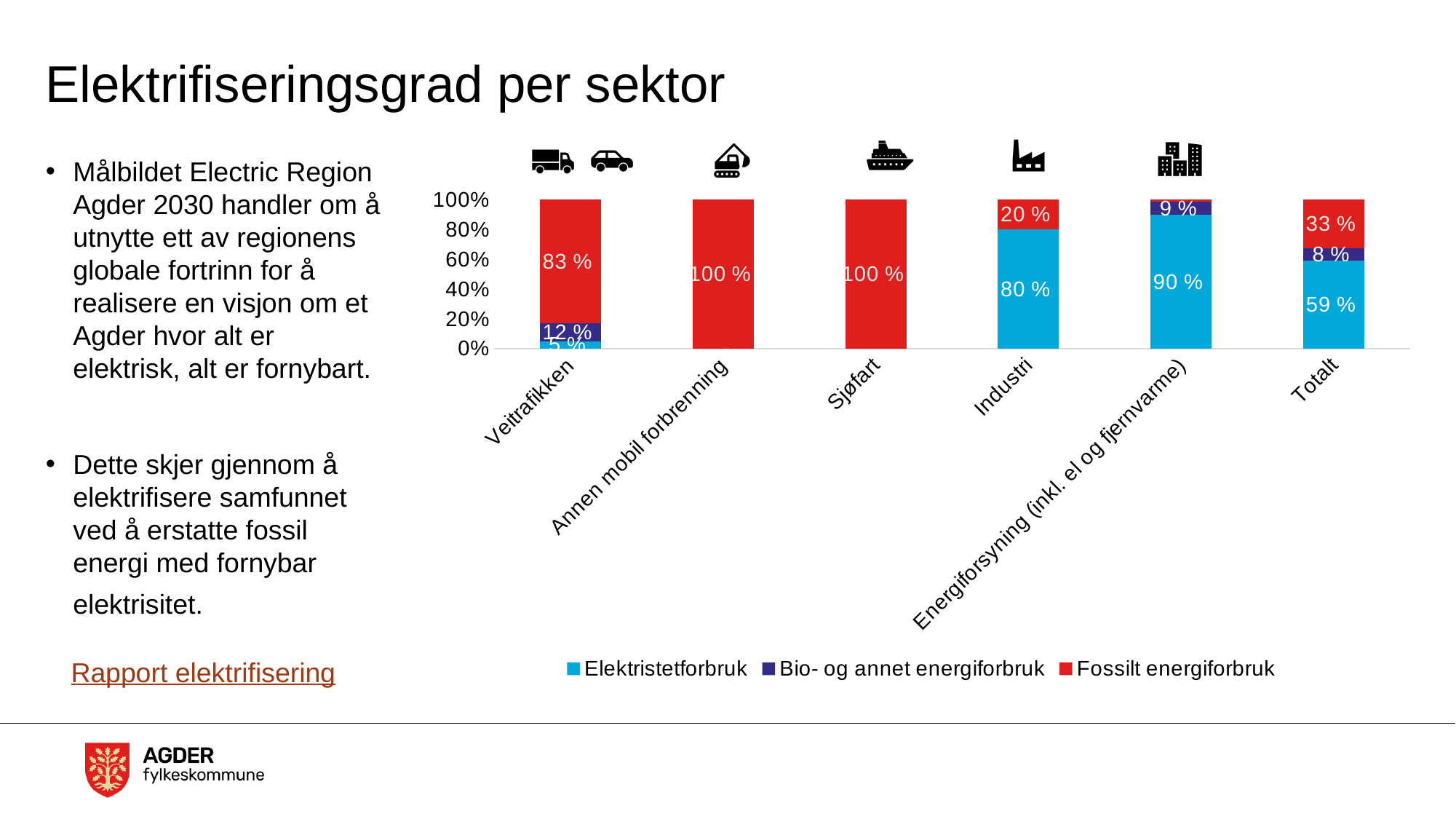
Which category has the highest Elektristetforbruk share? Energiforsyning (inkl. el og fjernvarme) Which is larger: the Elektristetforbruk share for Industri or for Totalt? Industri How many series does the legend list? 3 What kind of chart is shown on the slide? Stacked bar chart What is the Elektristetforbruk share for Energiforsyning (inkl. el og fjernvarme)? 90 % What is the Elektristetforbruk share for Industri? 80 % How many categories are shown on the x axis? 6 What is the title of the slide containing the chart? Elektrifiseringsgrad per sektor What is the difference between the Fossilt energiforbruk share for Veitrafikken and for Totalt? 50 % Which categories have a Fossilt energiforbruk share of 100 %? Annen mobil forbrenning and Sjøfart What is the Bio- og annet energiforbruk share for Totalt? 8 % What is the Fossilt energiforbruk share for Veitrafikken? 83 %